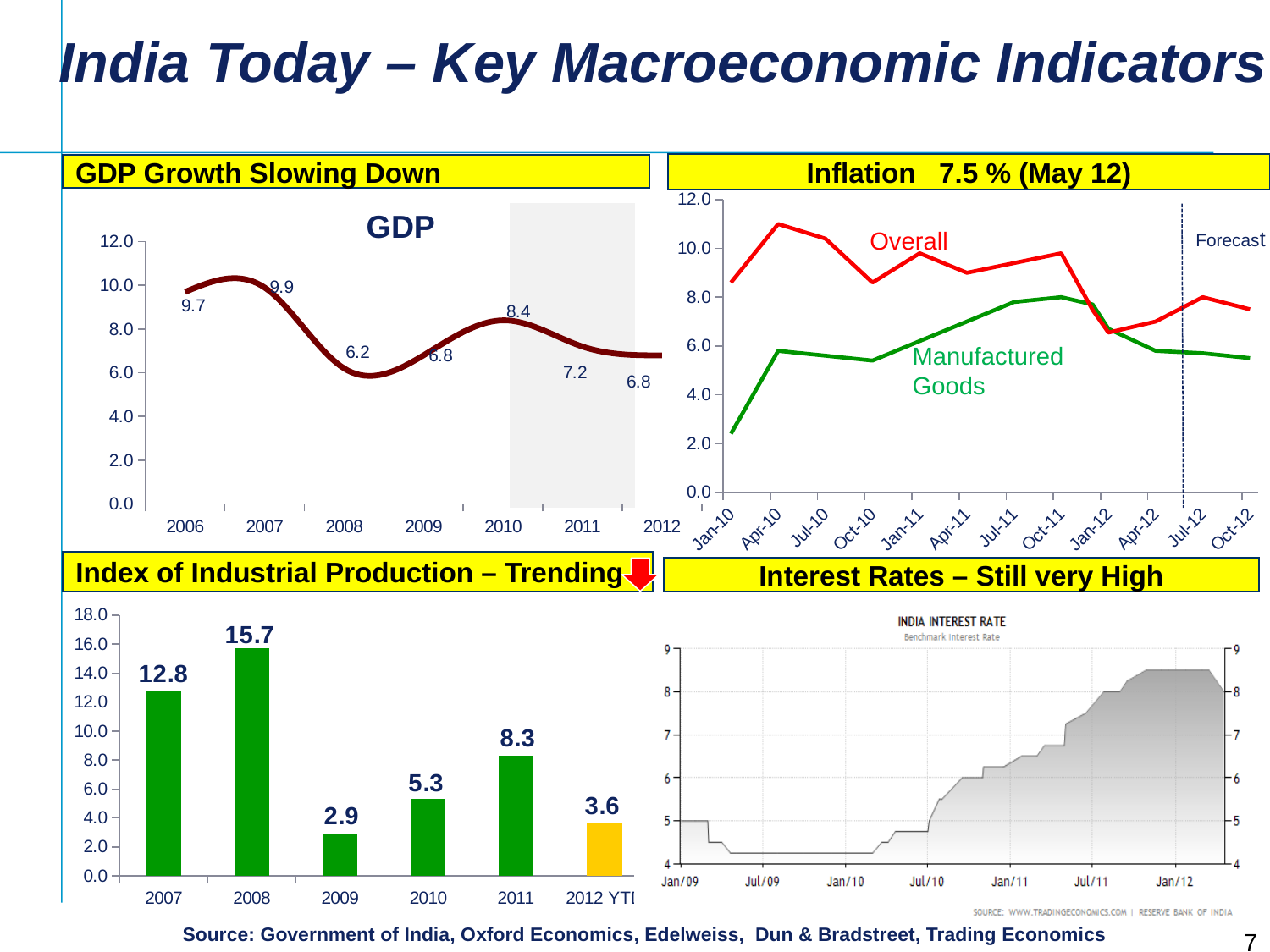
In the GDP chart, what is the GDP growth value for 2008? 6.2 In the Index of Industrial Production chart, what is the difference between the 2008 value and the 2007 value? 2.9 In the Inflation chart, is the Overall value for Apr-10 greater or less than 10.0? greater In the GDP chart, what is the GDP growth value for 2010? 8.4 In the Index of Industrial Production chart, which year has the lowest value? 2009 In the Index of Industrial Production chart, what is the value for 2011? 8.3 In the GDP chart, which year has the highest GDP growth value? 2007 In the Inflation chart, which series is drawn in green? Manufactured Goods What kind of chart is the Index of Industrial Production chart? Bar chart In the Index of Industrial Production chart, which year has the highest value? 2008 In the GDP chart, what is the difference between the 2006 value and the 2012 value? 2.9 In the Index of Industrial Production chart, how many bars are plotted? 6